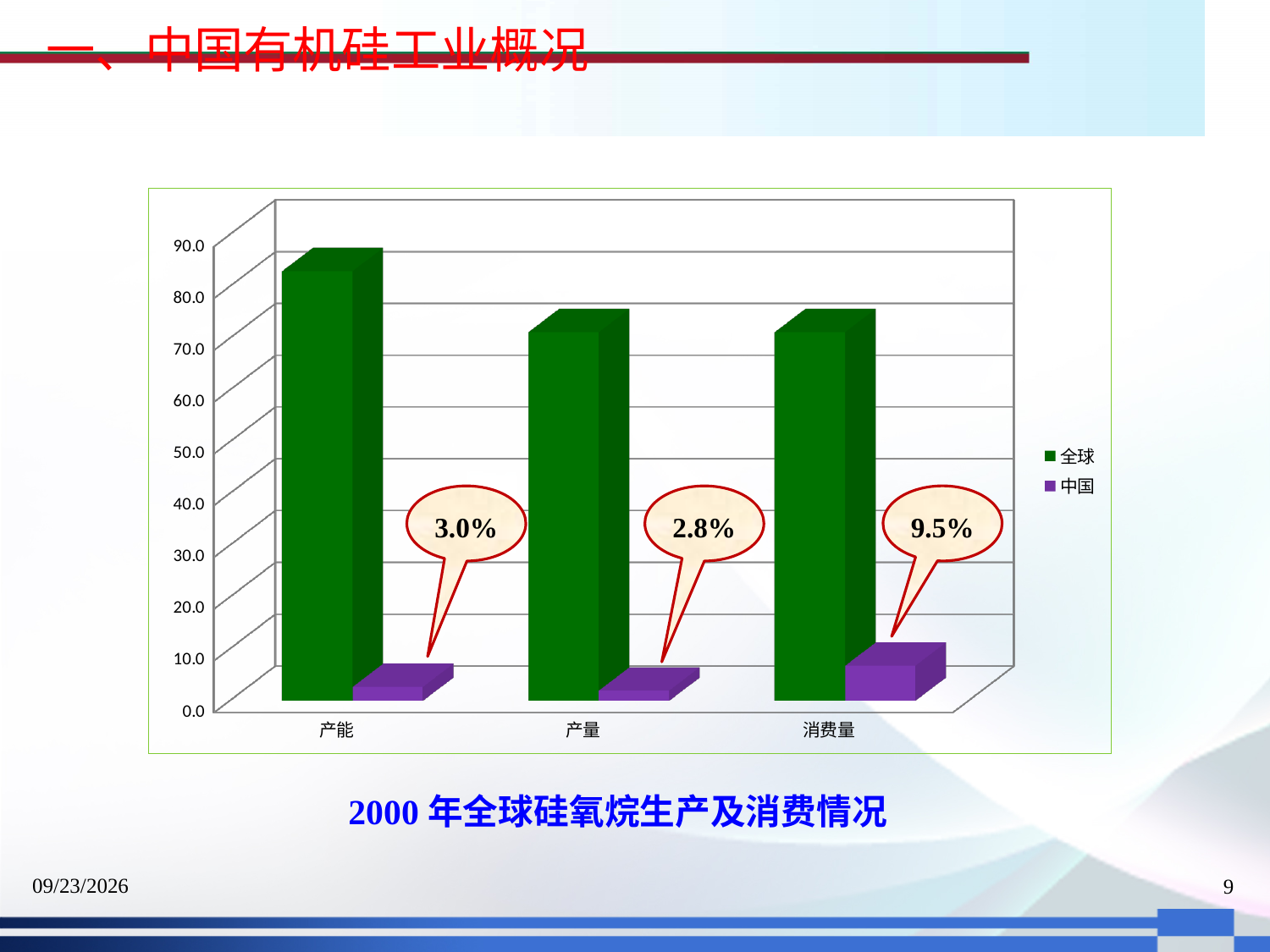
Which category has the highest value for the 中国 series? 消费量 Which is larger for the 全球 series: 产能 or 产量? 产能 Is the 中国 value for 产能 greater or less than 20.0? less How many series does the chart legend list? 2 What kind of chart is shown on the slide? bar chart Which colour represents the 中国 series in the chart legend? purple Is the 全球 value for 产能 greater or less than 70.0? greater Which category has the highest value for the 全球 series? 产能 What percentage is shown in the callout pointing to the 中国 bar for 消费量? 9.5% Which is larger for the 中国 series: 消费量 or 产量? 消费量 How many categories are shown on the x axis of the chart? 3 Is the 全球 value for 产量 greater or less than 80.0? less